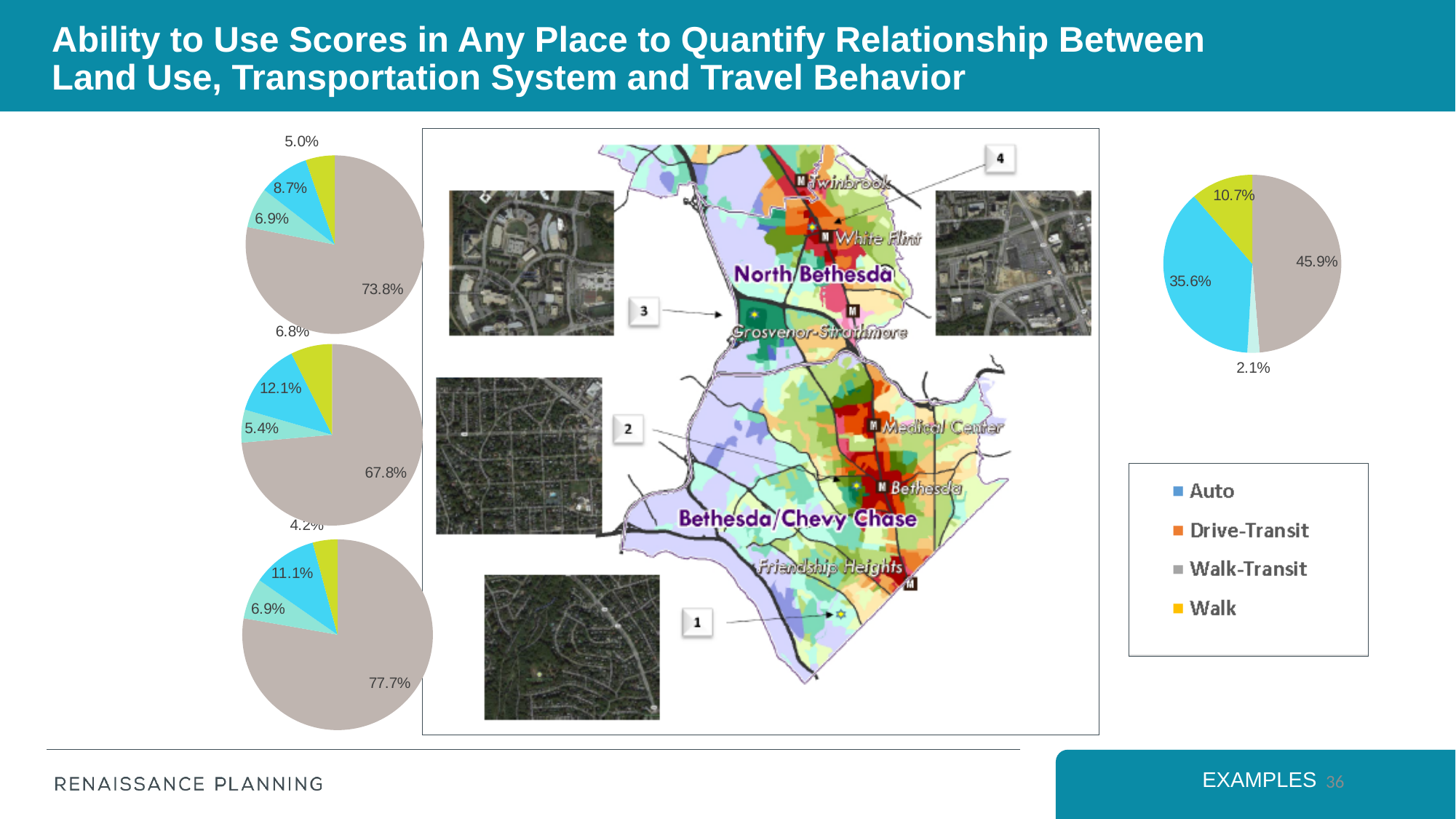
In the bottom-left pie chart, what is the value of the largest slice? 77.7% How many entries does the legend on the right of the slide list? 4 In the pie chart on the right side of the slide, what is the difference between the largest slice (45.9%) and the second-largest slice (35.6%)? 10.3% What kind of charts are shown on the left and right sides of the slide? Pie charts In the middle-left pie chart, what is the value of the largest slice? 67.8% In the top-left pie chart, what is the value of the largest slice? 73.8% How many slices does each pie chart on the slide have? 4 In the pie chart on the right side of the slide, what is the value of the smallest slice? 2.1% In the middle-left pie chart, what is the value of the smallest slice? 5.4% In the bottom-left pie chart, what is the value of the smallest slice? 4.2%